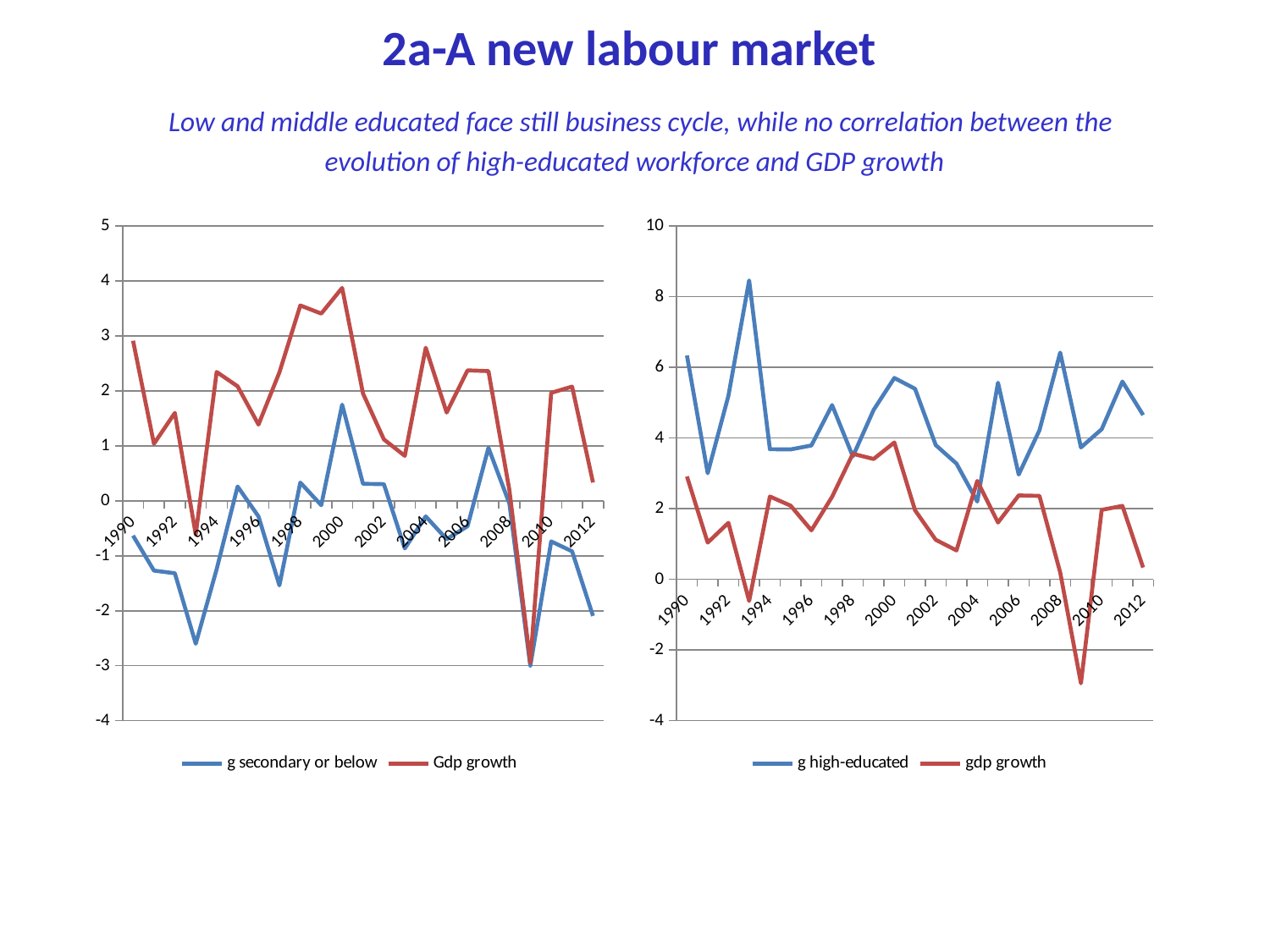
How many series does the legend of the right chart list? 2 In the right chart, is the value for gdp growth in 2009 greater or less than -2? less In the left chart, does Gdp growth rise or fall from 2010 to 2012? fall In the left chart, is the value for Gdp growth in 2000 greater or less than 3? greater In the right chart, which series has the higher value in 1993, g high-educated or gdp growth? g high-educated In the left chart, which two series are listed in the legend? g secondary or below and Gdp growth In the left chart, which year has the highest value for Gdp growth? 2000 In the left chart, is the value for g secondary or below in 2009 greater or less than -2? less In the right chart, which year has the highest value for g high-educated? 1993 In the left chart, which year has the lowest value for g secondary or below? 2009 What kind of chart is the left chart on the slide? line chart